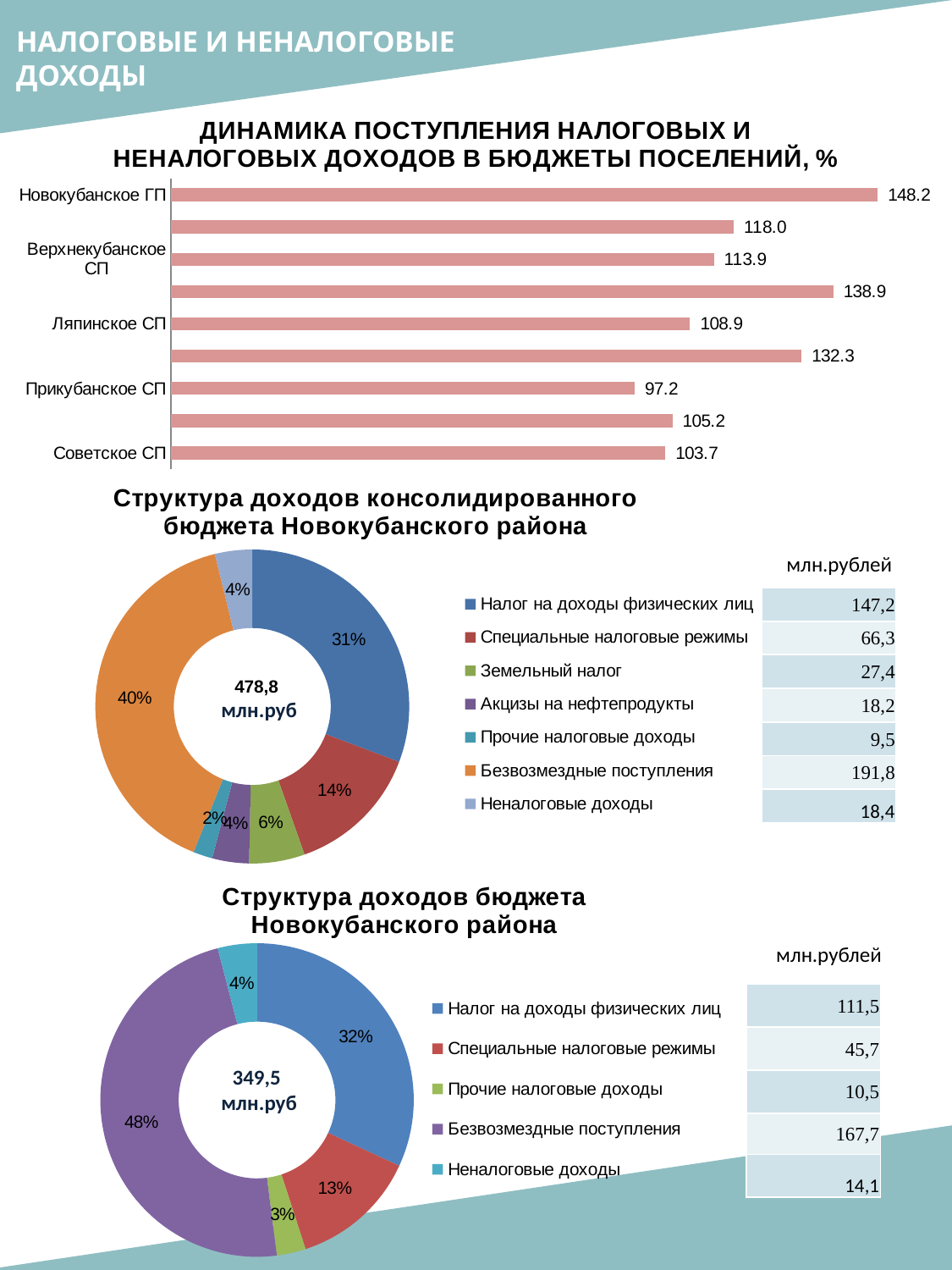
On the chart 'Структура доходов консолидированного бюджета Новокубанского района', what share does Безвозмездные поступления have? 40% What type of chart is 'Динамика поступления налоговых и неналоговых доходов в бюджеты поселений, %'? Bar chart How many categories does the legend list on the chart 'Структура доходов консолидированного бюджета Новокубанского района'? 7 On the bar chart 'Динамика поступления налоговых и неналоговых доходов в бюджеты поселений, %', what is the value for Новокубанское ГП? 148.2 On the chart 'Структура доходов бюджета Новокубанского района', which category has the largest share? Безвозмездные поступления On the bar chart 'Динамика поступления налоговых и неналоговых доходов в бюджеты поселений, %', what is the value for Советское СП? 103.7 On the bar chart 'Динамика поступления налоговых и неналоговых доходов в бюджеты поселений, %', what is the difference between the values for Новокубанское ГП and Прикубанское СП? 51.0 How many bars are plotted on the bar chart 'Динамика поступления налоговых и неналоговых доходов в бюджеты поселений, %'? 9 On the bar chart 'Динамика поступления налоговых и неналоговых доходов в бюджеты поселений, %', which labelled settlement has the lowest value? Прикубанское СП On the bar chart 'Динамика поступления налоговых и неналоговых доходов в бюджеты поселений, %', which is larger: the value for Верхнекубанское СП or for Ляпинское СП? Верхнекубанское СП On the chart 'Структура доходов консолидированного бюджета Новокубанского района', what is the value in млн.рублей for Налог на доходы физических лиц? 147,2 On the chart 'Структура доходов бюджета Новокубанского района', what is the value in млн.рублей for Неналоговые доходы? 14,1